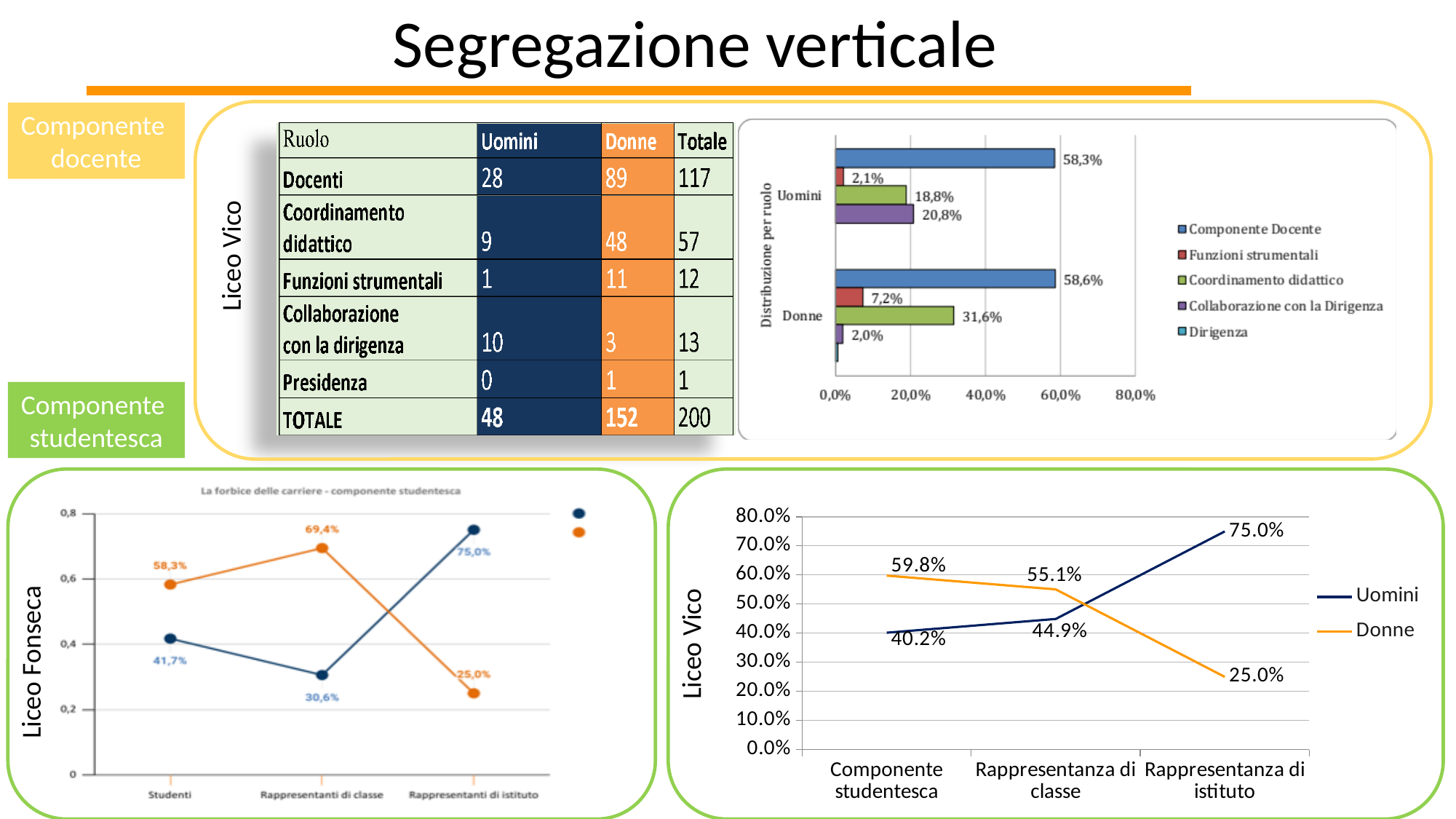
In the bottom-right line chart (Liceo Vico), what is the value for Uomini at Rappresentanza di istituto? 75.0% In the bottom-left line chart (Liceo Fonseca), what is the value of the blue series at Rappresentanti di classe? 30,6% In the bottom-right line chart (Liceo Vico), what is the difference between the Donne and Uomini values at Componente studentesca? 19.6 percentage points In the bottom-right line chart (Liceo Vico), what is the value for Donne at Componente studentesca? 59.8% What kind of chart is the bottom-right chart (Liceo Vico)? line chart How many series does the legend of the bottom-right line chart (Liceo Vico) list? 2 In the bottom-left line chart (Liceo Fonseca), at which category does the orange series reach its highest value? Rappresentanti di classe In the bottom-right line chart (Liceo Vico), does the Donne line rise or fall from Componente studentesca to Rappresentanza di istituto? fall In the top-right bar chart (Distribuzione per ruolo), which series has the highest value for Uomini? Componente Docente How many series does the legend of the top-right bar chart (Distribuzione per ruolo) list? 5 In the top-right bar chart (Distribuzione per ruolo), what is the value for Coordinamento didattico among Donne? 31,6% What kind of chart is the top-right chart (Distribuzione per ruolo)? bar chart